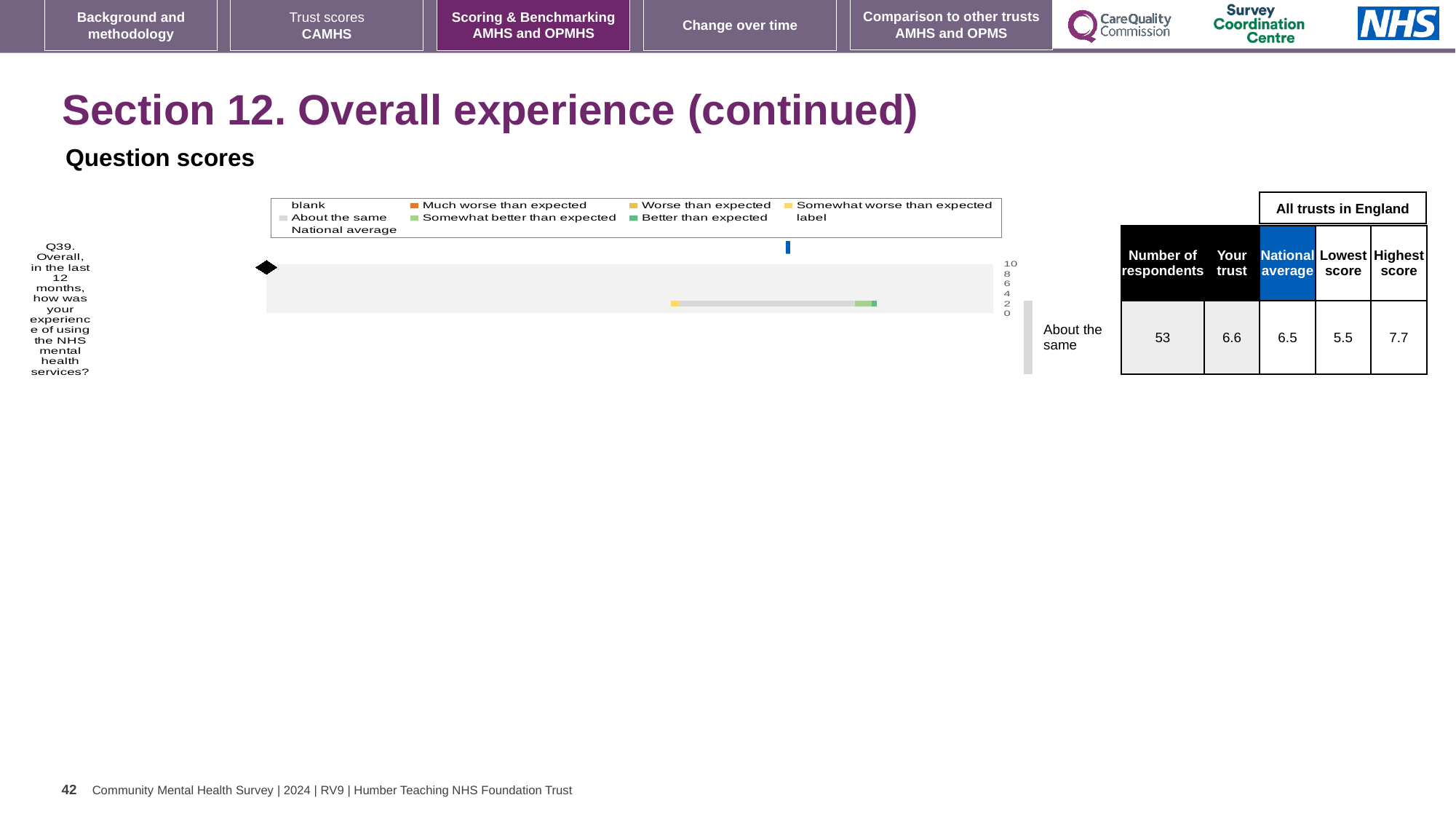
Which is higher for Q39: the trust's score or the national average? Your trust Which benchmark category does the trust fall into for Q39? About the same How many survey questions are plotted on the chart? 1 How many respondents answered Q39? 53 By how much does the trust's score for Q39 exceed the national average? 0.1 Which legend entry is shown in blue on the chart? National average What is the national average score for Q39? 6.5 What is the 'Your trust' score for Q39 (overall experience of using NHS mental health services)? 6.6 What is the difference between the highest score and the lowest score for Q39? 2.2 What kind of chart is used to show the Q39 question score? bar chart What is the lowest score among all trusts in England for Q39? 5.5 What is the highest score among all trusts in England for Q39? 7.7